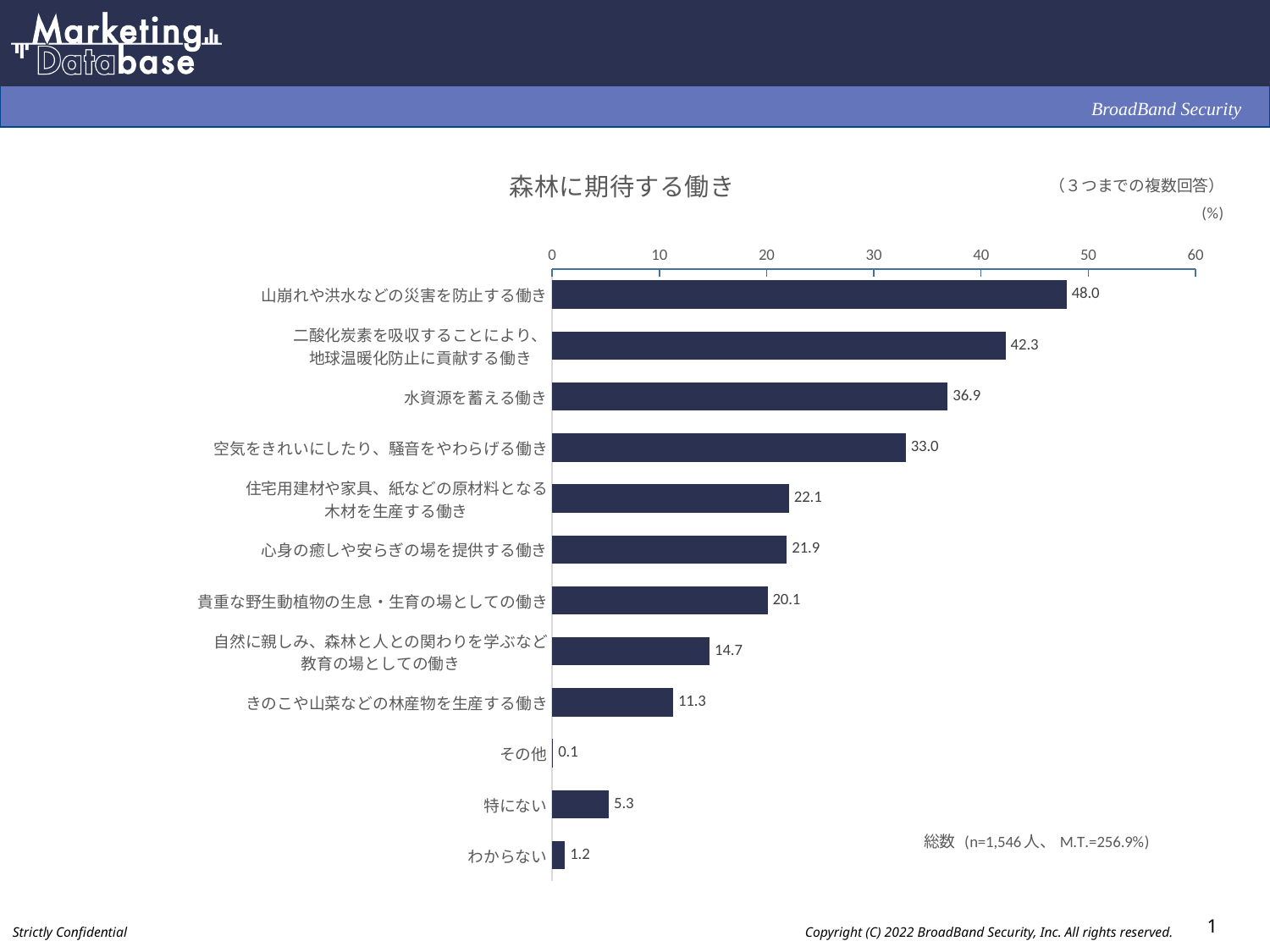
What type of chart is shown on the slide? bar chart What is the value for 水資源を蓄える働き? 36.9 What is the value for きのこや山菜などの林産物を生産する働き? 11.3 Which category has the lowest value? その他 What is the value for 山崩れや洪水などの災害を防止する働き? 48.0 What is the value for 特にない? 5.3 Which category has the highest value? 山崩れや洪水などの災害を防止する働き What is the title of the chart? 森林に期待する働き What is the difference between the values for 山崩れや洪水などの災害を防止する働き and 二酸化炭素を吸収することにより、地球温暖化防止に貢献する働き? 5.7 What is the sample size (n) shown on the slide? 1,546人 How many categories are plotted in the chart? 12 Which is larger, the value for 水資源を蓄える働き or the value for 空気をきれいにしたり、騒音をやわらげる働き? 水資源を蓄える働き